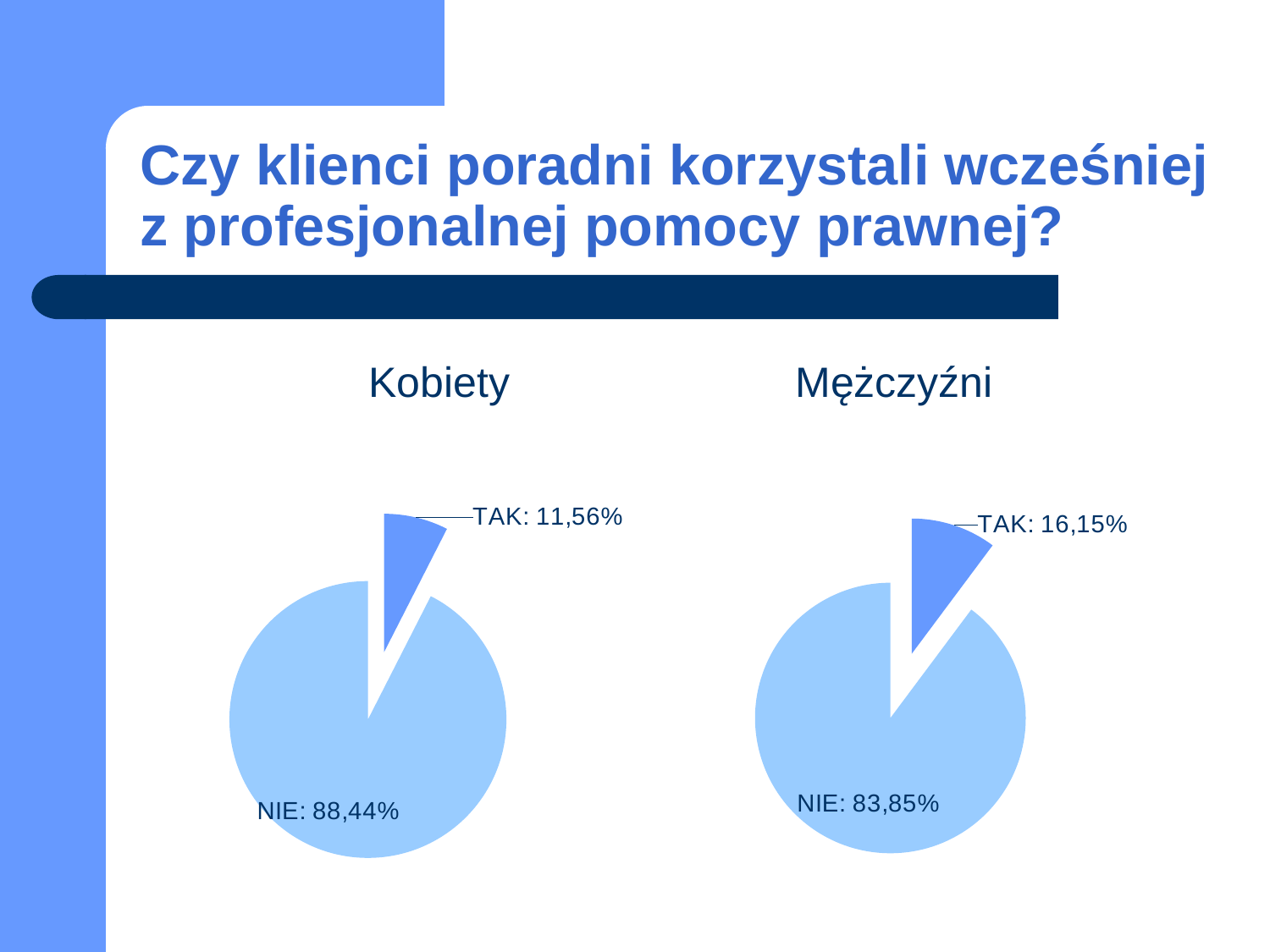
In the Kobiety chart, what is the value for NIE? 88,44% How many slices does the Mężczyźni chart have? 2 Which is larger: the TAK share in the Kobiety chart or the TAK share in the Mężczyźni chart? Mężczyźni In the Mężczyźni chart, what is the value for NIE? 83,85% In the Kobiety chart, what is the difference between the NIE and TAK shares? 76,88% In the Mężczyźni chart, which slice is the smallest? TAK In the Mężczyźni chart, what is the value for TAK? 16,15% What kind of chart is the Kobiety chart? pie chart In the Kobiety chart, what is the value for TAK? 11,56% In the Kobiety chart, which slice is the largest? NIE How many charts are shown on the slide? 2 What is the difference between the TAK share in the Mężczyźni chart and the TAK share in the Kobiety chart? 4,59%